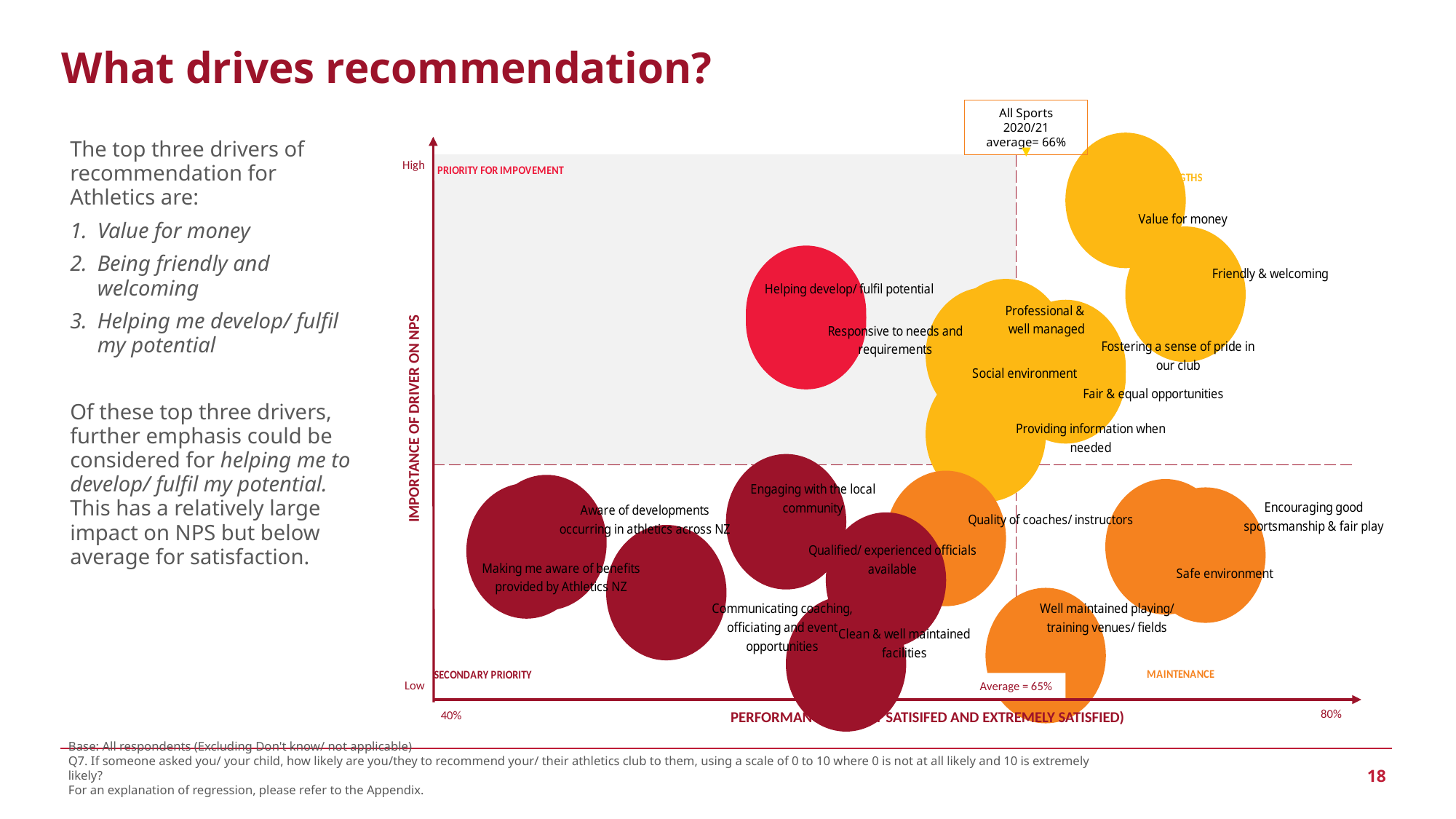
What is the All Sports 2020/21 average shown above the chart? 66% What is the label of the vertical axis? Importance of driver on NPS What is the highest value labelled on the performance (x) axis? 80% Which has the higher importance on NPS: Value for money or Safe environment? Value for money What is the lowest value labelled on the performance (x) axis? 40% What kind of chart is shown on the slide? bubble chart Which driver has the highest importance on NPS (the topmost bubble)? Value for money Is the performance value for Value for money greater or less than 65%? greater Which driver has the lowest importance on NPS (the bottommost bubble)? Clean & well maintained facilities Is the performance value for Making me aware of benefits provided by Athletics NZ greater or less than 65%? less What is the label of the top-left quadrant of the chart? Priority for improvement What is the average performance value marked by the vertical dashed line? 65%